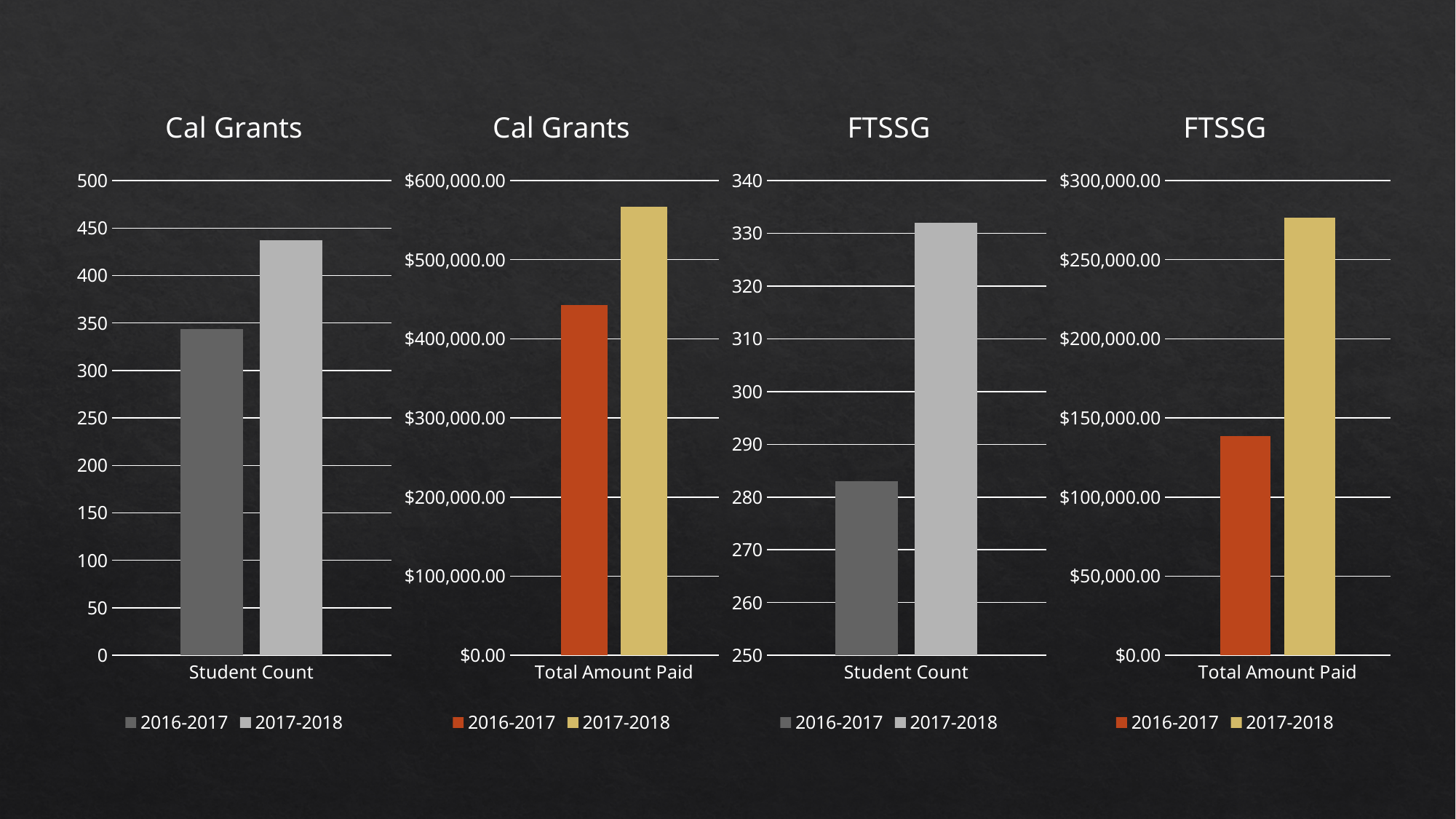
What kind of chart is the leftmost chart (Cal Grants, Student Count)? bar chart In the rightmost chart (FTSSG, Total Amount Paid), is the value for 2016-2017 greater or less than $150,000.00? less In the rightmost chart (FTSSG, Total Amount Paid), is the value for 2017-2018 greater or less than $250,000.00? greater In the third chart from the left (FTSSG, Student Count), is the value for 2016-2017 greater or less than 300? less In the third chart from the left (FTSSG, Student Count), which series has the higher value, 2016-2017 or 2017-2018? 2017-2018 How many series does the legend of the rightmost chart (FTSSG, Total Amount Paid) list? 2 In the leftmost chart (Cal Grants, Student Count), which series has the taller bar, 2016-2017 or 2017-2018? 2017-2018 What is the category label on the x axis of the second chart from the left (Cal Grants)? Total Amount Paid